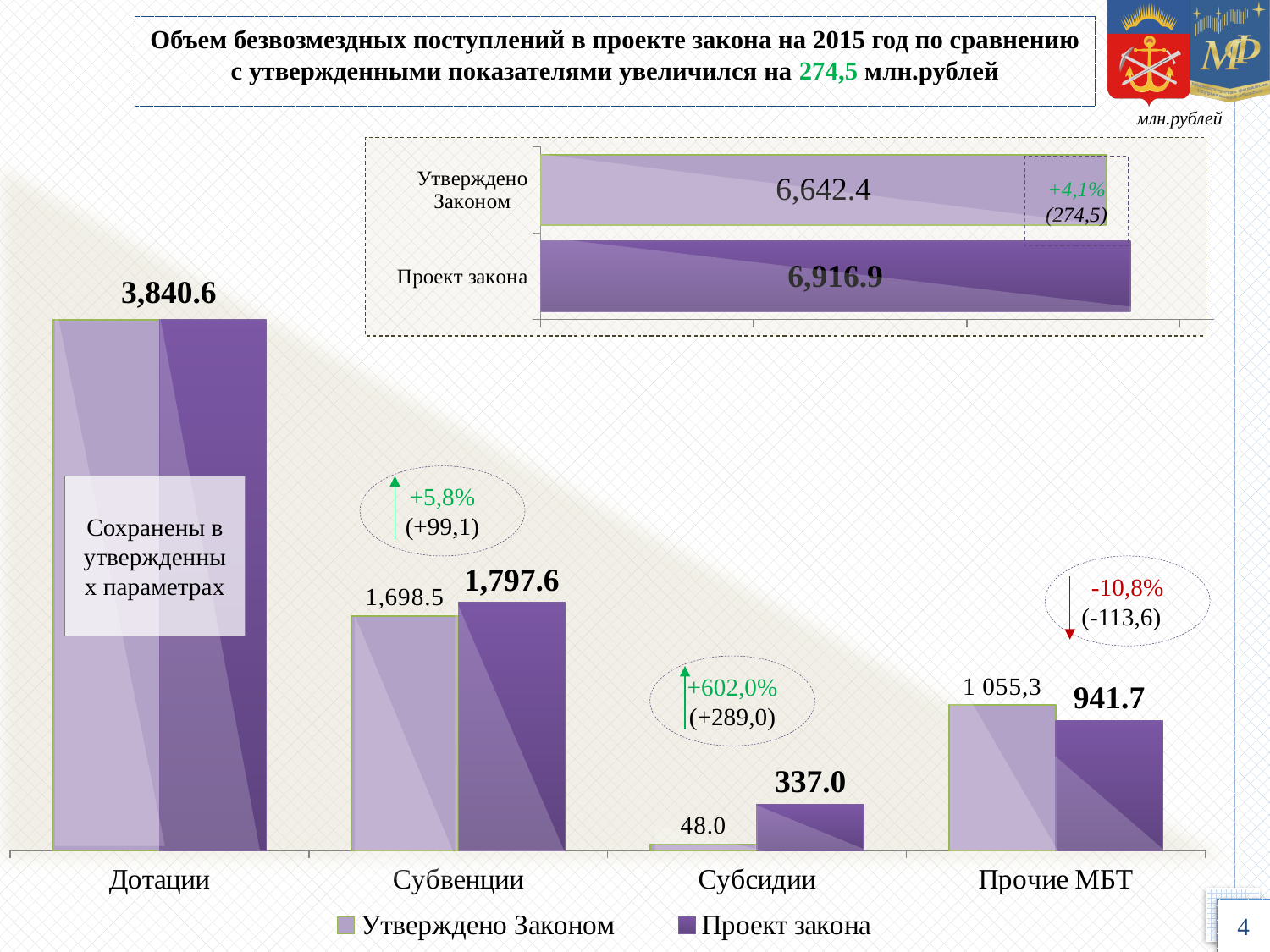
In the large bar chart at the bottom, what is the difference between Проект закона and Утверждено Законом for Субсидии? 289.0 In the large bar chart at the bottom, what is the value of Проект закона for Прочие МБТ? 941.7 In the small chart at the top right, what is the value for Проект закона? 6,916.9 How many categories are shown on the x axis of the large bar chart at the bottom? 4 In the large bar chart at the bottom, what is the value of Проект закона for Субвенции? 1,797.6 In the large bar chart at the bottom, what is the value of Утверждено Законом for Субвенции? 1,698.5 What kind of chart is the small chart at the top right? Bar chart In the large bar chart at the bottom, which is larger for Прочие МБТ: Утверждено Законом or Проект закона? Утверждено Законом How many series does the legend of the large bar chart at the bottom list? 2 In the large bar chart at the bottom, what is the value of Утверждено Законом for Субсидии? 48.0 In the large bar chart at the bottom, which category has the lowest value for Утверждено Законом? Субсидии In the large bar chart at the bottom, which category has the highest value for Проект закона? Дотации